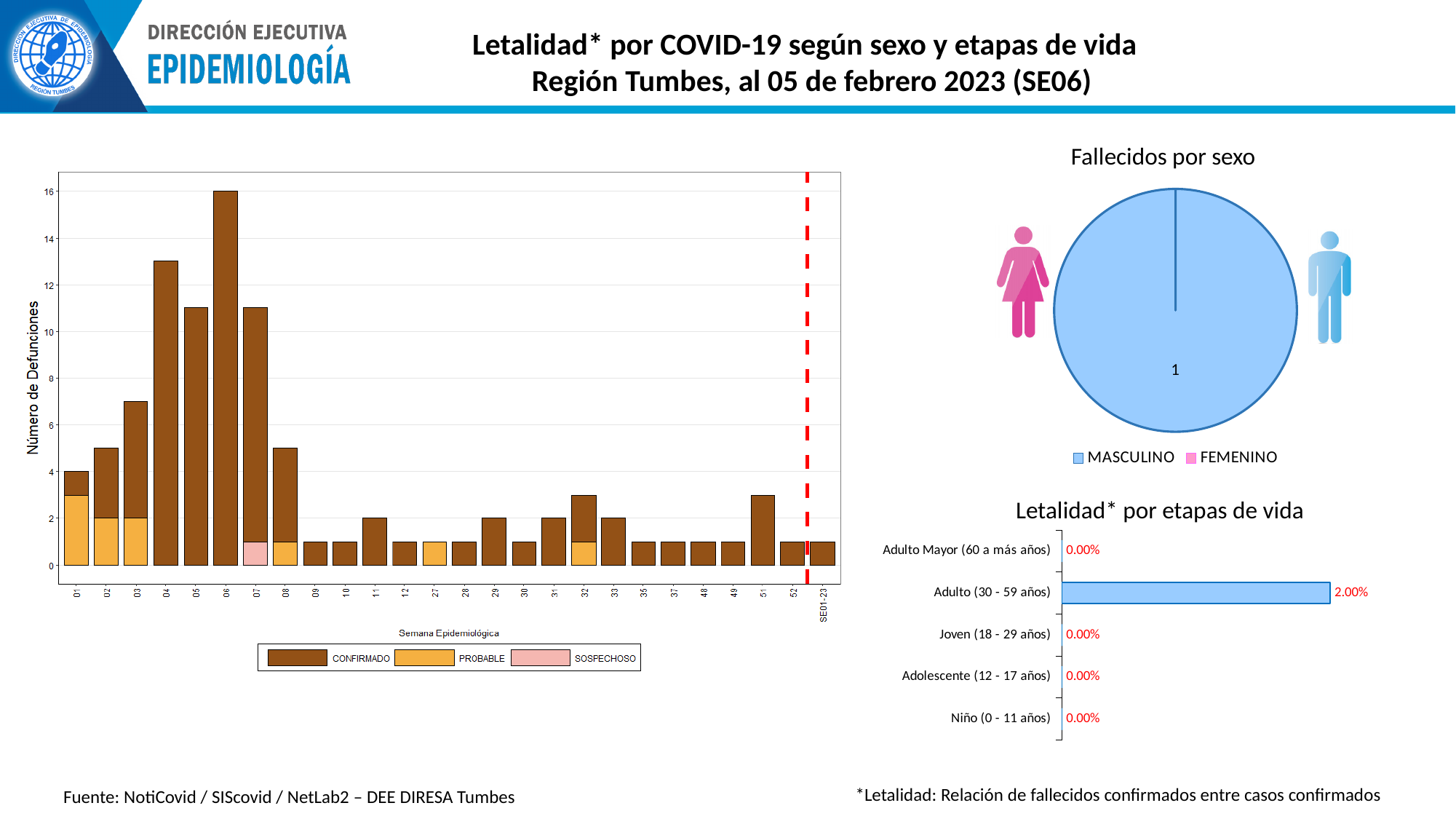
How many age-group categories are shown in the 'Letalidad* por etapas de vida' chart? 5 How many series does the legend of the bar chart on the left (Número de Defunciones by Semana Epidemiológica) list? 3 In the 'Fallecidos por sexo' chart, what value is printed on the MASCULINO slice? 1 In the 'Letalidad* por etapas de vida' chart, what is the value for Adulto (30 - 59 años)? 2.00% What kind of chart is 'Letalidad* por etapas de vida'? Bar chart In the 'Letalidad* por etapas de vida' chart, which age group has the highest value? Adulto (30 - 59 años) In the bar chart on the left (Número de Defunciones by Semana Epidemiológica), which week has the highest total number of deaths? 06 In the bar chart on the left (Número de Defunciones by Semana Epidemiológica), what is the total number of deaths for week 06? 16 How many series does the legend of the 'Fallecidos por sexo' chart list? 2 In the 'Letalidad* por etapas de vida' chart, what is the value for Niño (0 - 11 años)? 0.00% In the bar chart on the left (Número de Defunciones by Semana Epidemiológica), is the total for week 04 greater or less than 12? greater What kind of chart is 'Fallecidos por sexo'? Pie chart